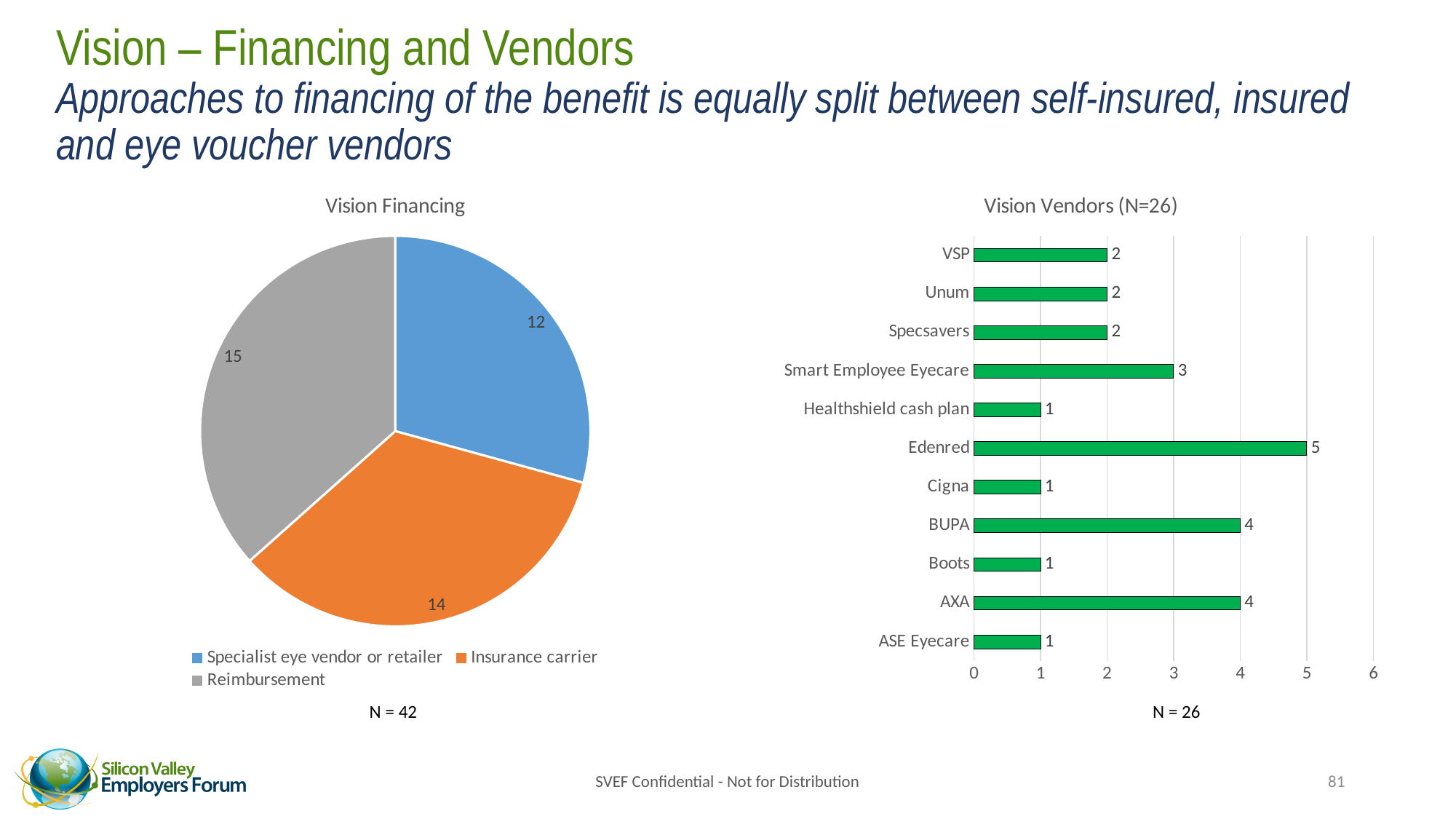
In the Vision Vendors (N=26) chart, what is the difference between Edenred and Cigna? 4 In the Vision Vendors (N=26) chart, which vendor has the highest value? Edenred In the Vision Vendors (N=26) chart, how many vendors are listed? 11 In the Vision Financing chart, how many categories does the legend list? 3 In the Vision Vendors (N=26) chart, what kind of chart is shown? bar chart In the Vision Vendors (N=26) chart, what is the value for Edenred? 5 In the Vision Financing chart, which category has the smallest slice? Specialist eye vendor or retailer In the Vision Financing chart, what is the value for Insurance carrier? 14 In the Vision Financing chart, what kind of chart is shown? pie chart In the Vision Financing chart, which category has the largest slice? Reimbursement In the Vision Financing chart, what is the difference between Reimbursement and Specialist eye vendor or retailer? 3 In the Vision Vendors (N=26) chart, which is larger, BUPA or Smart Employee Eyecare? BUPA